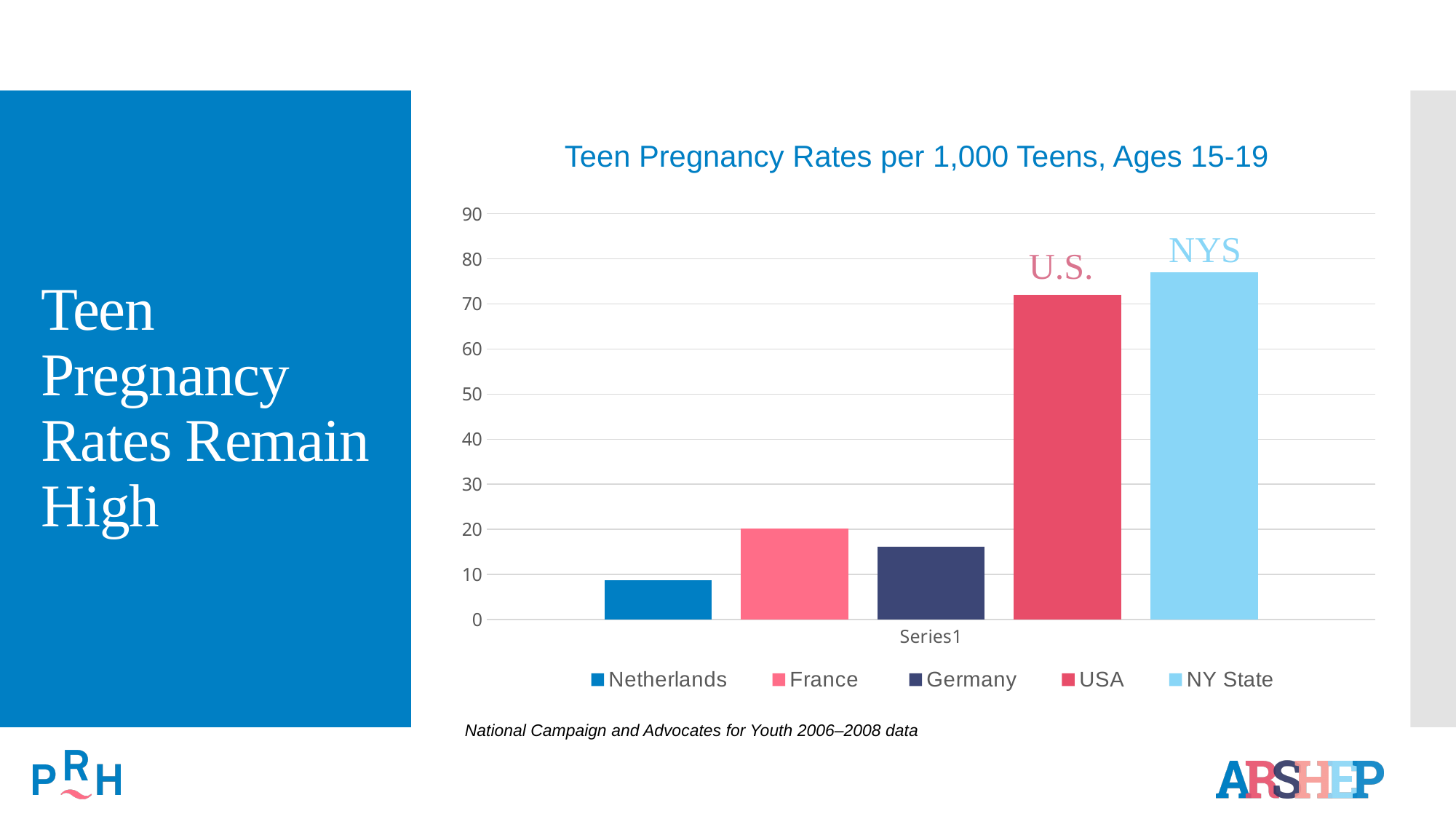
Is the value for NY State greater or less than 80? less How many bars are plotted in the chart? 5 Is the value for USA greater or less than 70? greater Which series has the lowest teen pregnancy rate? Netherlands Is the value for Netherlands greater or less than 10? less Which has a higher teen pregnancy rate, France or Germany? France How many series does the legend list? 5 Which has a higher teen pregnancy rate, USA or NY State? NY State What is the title of the chart? Teen Pregnancy Rates per 1,000 Teens, Ages 15-19 Which series has the highest teen pregnancy rate? NY State What kind of chart is shown on the slide? bar chart